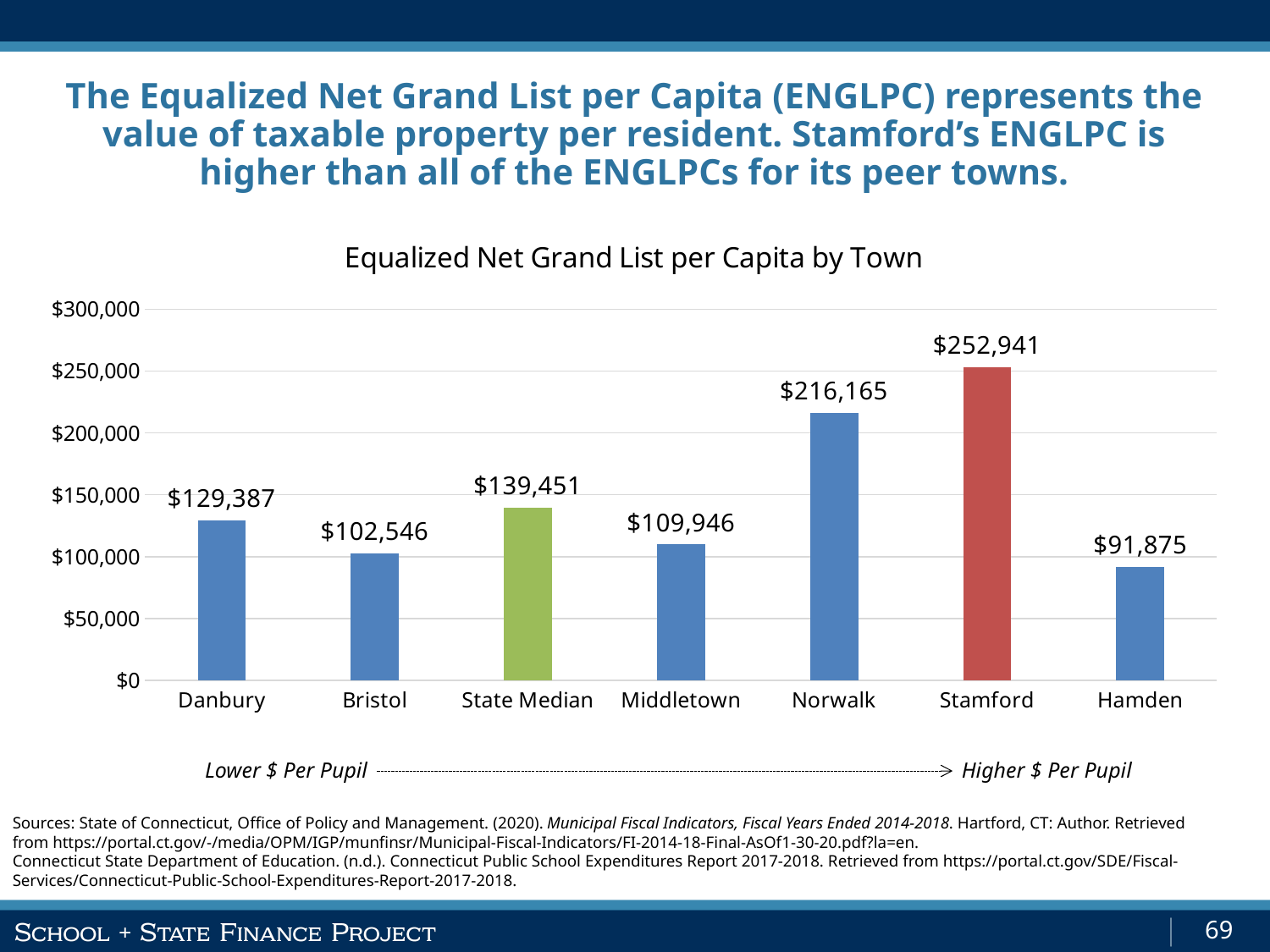
What is the value shown for Norwalk? $216,165 What type of chart is shown on the slide? Bar chart Which town has the lowest Equalized Net Grand List per Capita? Hamden Which is larger, the value for Middletown or the value for Bristol? Middletown What is the difference between Danbury's and Bristol's values? $26,841 What is the difference between Stamford's and Norwalk's values? $36,776 What is the State Median value shown on the chart? $139,451 Is the value for Danbury greater or less than $150,000? less What is the Equalized Net Grand List per Capita for Stamford? $252,941 What is the value shown for Hamden? $91,875 Which town has the highest Equalized Net Grand List per Capita? Stamford How many bars are shown on the chart? 7